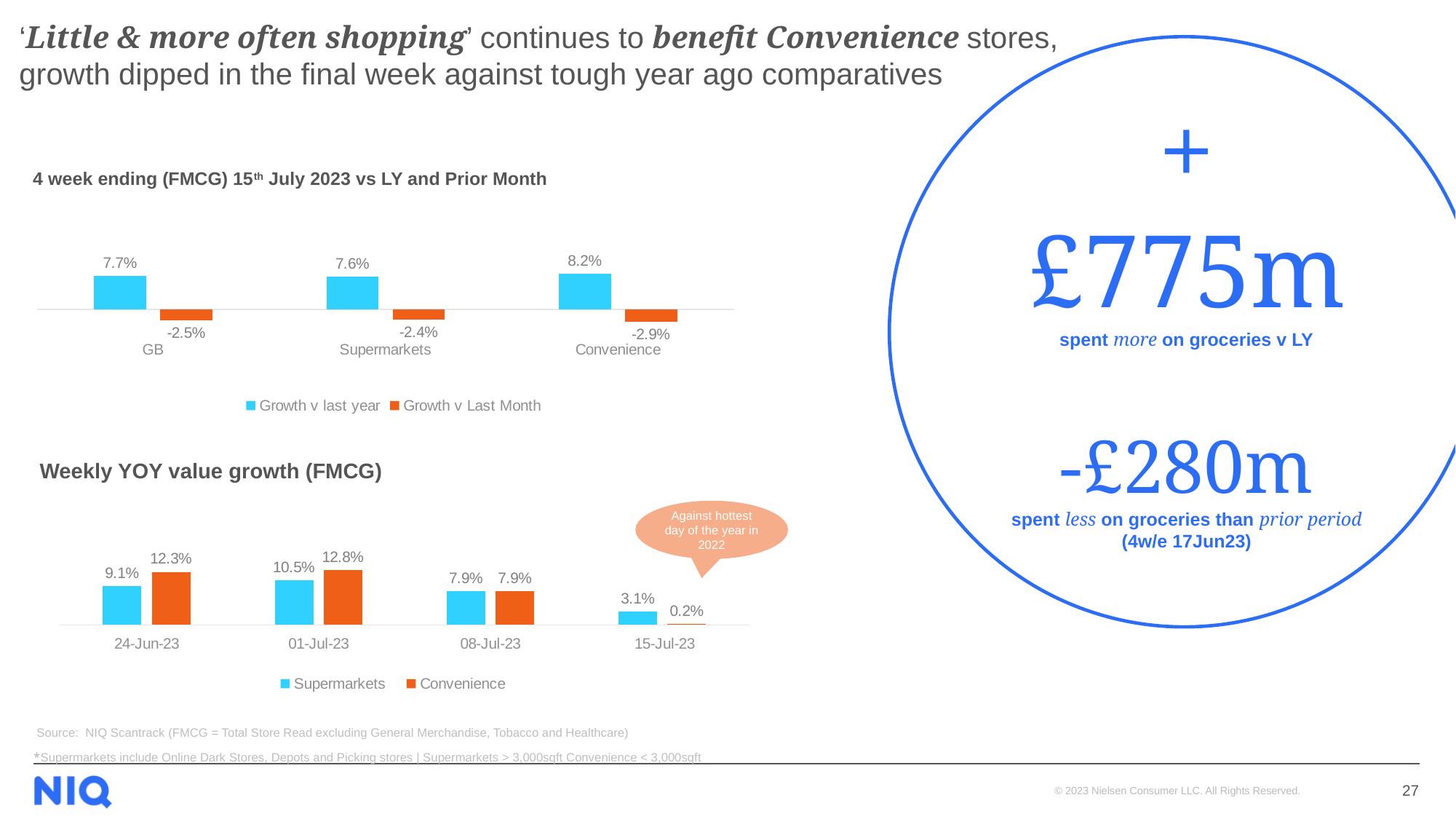
What kind of chart is the 'Weekly YOY value growth (FMCG)' chart? bar chart In the '4 week ending (FMCG) 15th July 2023 vs LY and Prior Month' chart, what is the Growth v Last Month value for GB? -2.5% In the 'Weekly YOY value growth (FMCG)' chart, what is the Supermarkets value for 15-Jul-23? 3.1% In the 'Weekly YOY value growth (FMCG)' chart, do the Supermarkets values rise or fall from 01-Jul-23 to 15-Jul-23? fall In the '4 week ending (FMCG) 15th July 2023 vs LY and Prior Month' chart, what is the Growth v last year value for Convenience? 8.2% In the 'Weekly YOY value growth (FMCG)' chart, how many weeks are shown on the x axis? 4 In the 'Weekly YOY value growth (FMCG)' chart, which week has the lowest Convenience value? 15-Jul-23 In the 'Weekly YOY value growth (FMCG)' chart, what is the difference between the Convenience and Supermarkets values for 24-Jun-23? 3.2% In the '4 week ending (FMCG) 15th July 2023 vs LY and Prior Month' chart, which category has the highest Growth v last year? Convenience In the '4 week ending (FMCG) 15th July 2023 vs LY and Prior Month' chart, how many series does the legend list? 2 In the '4 week ending (FMCG) 15th July 2023 vs LY and Prior Month' chart, which category has the lowest Growth v Last Month? Convenience In the 'Weekly YOY value growth (FMCG)' chart, what is the Convenience value for 01-Jul-23? 12.8%